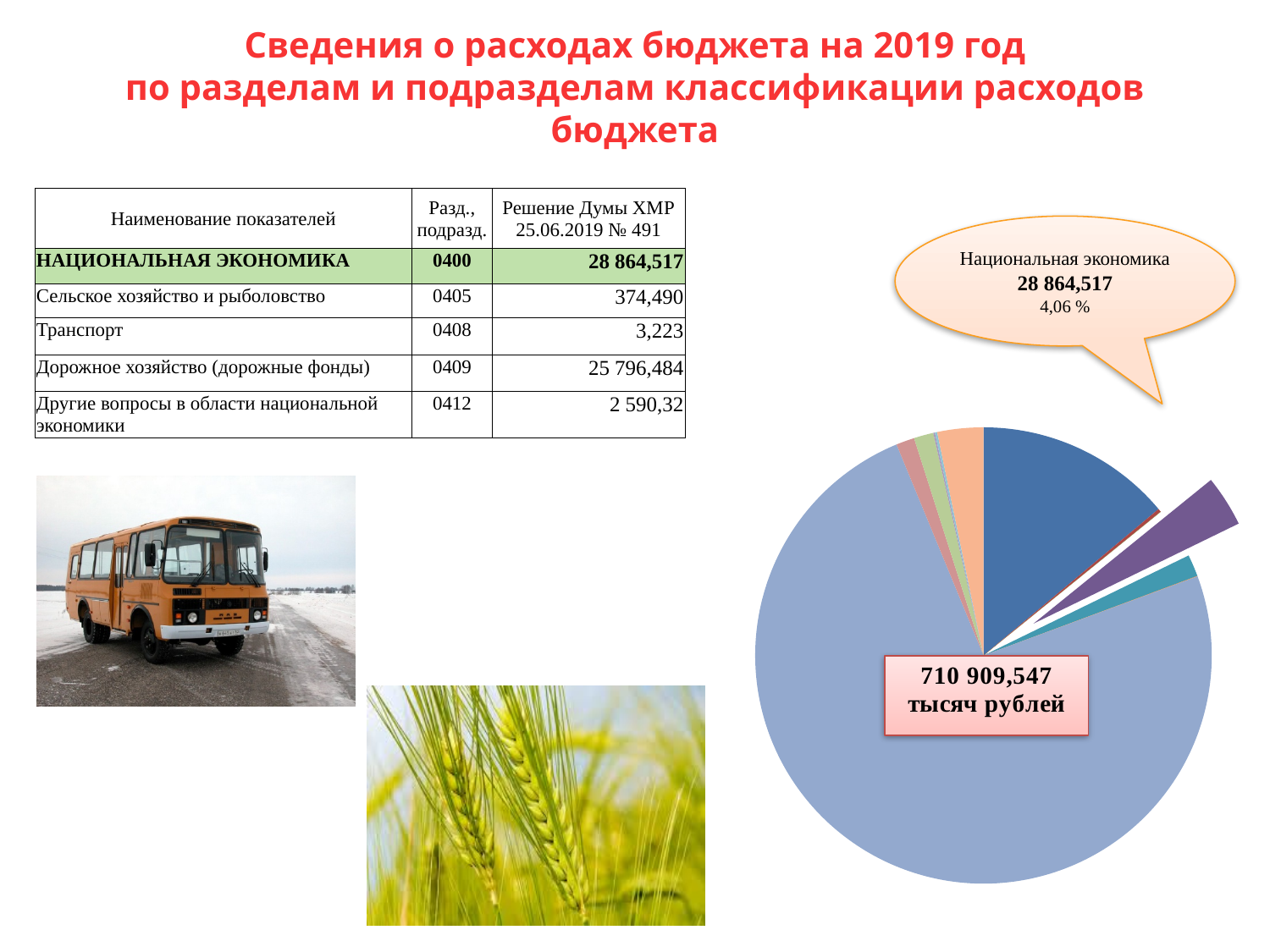
What total amount is printed in the box on the pie chart? 710 909,547 тысяч рублей What kind of chart is shown on the right side of the slide? pie chart Does the pie chart have a legend listing its categories? No Which slice of the pie chart is pulled out (exploded) from the rest? the purple slice What share of the pie does the Национальная экономика slice represent, according to the callout? 4,06 % Is the Национальная экономика slice larger or smaller than half of the pie? smaller According to the callout on the pie chart, what is the value for Национальная экономика? 28 864,517